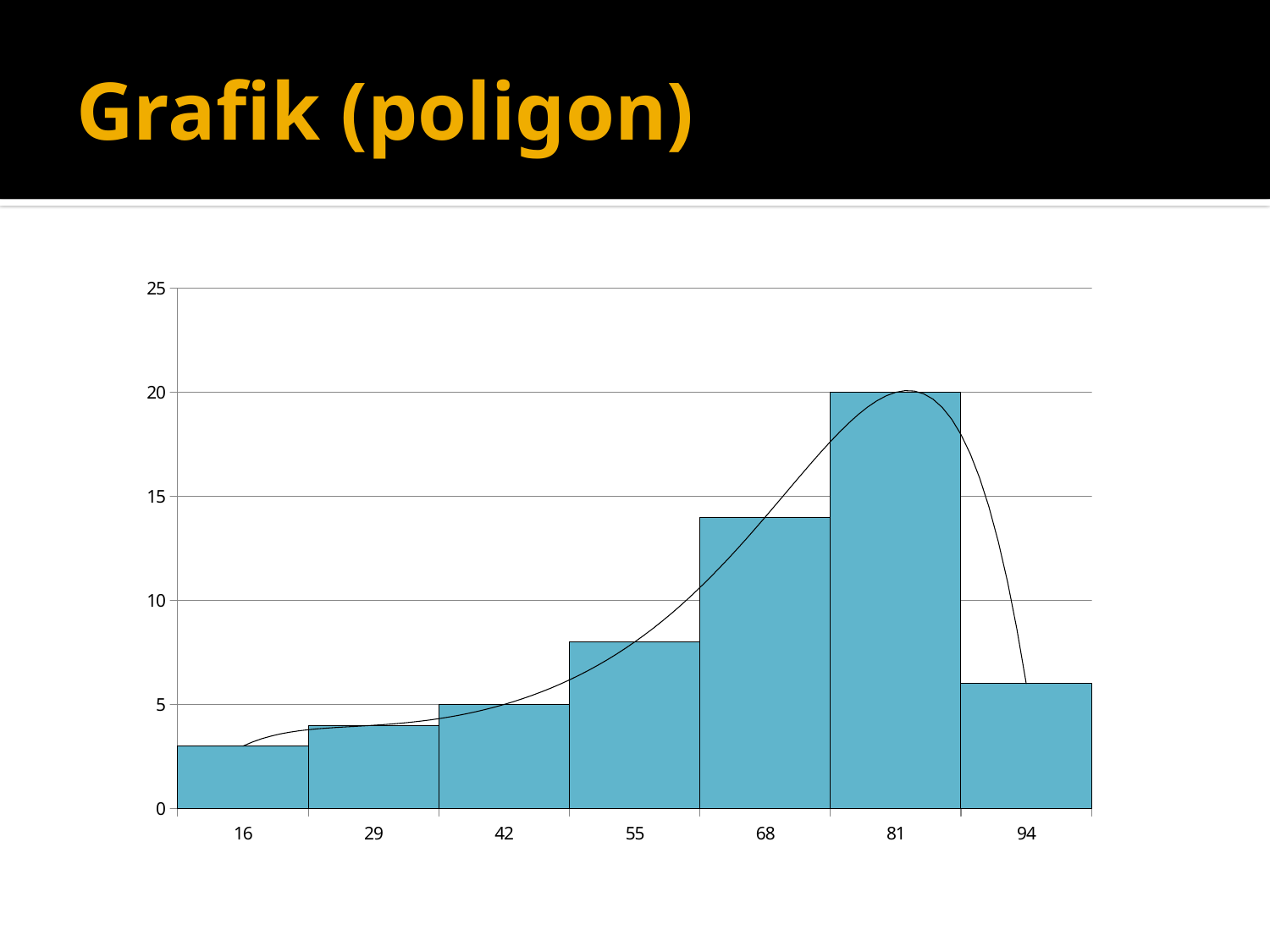
Which bar is taller, 68 or 94? 68 What is the difference between the bar at 81 and the bar at 42? 15 What is the value of the bar at 81? 20 What kind of chart is shown on the slide? Bar chart Which category has the highest bar? 81 What is the value of the bar at 42? 5 What is the title of the slide? Grafik (poligon) Is the value for 55 greater or less than 5? greater How many bars are shown in the chart? 7 Which category has the lowest bar? 16 Is the value for 68 greater or less than 10? greater Is the value for 94 greater or less than 10? less